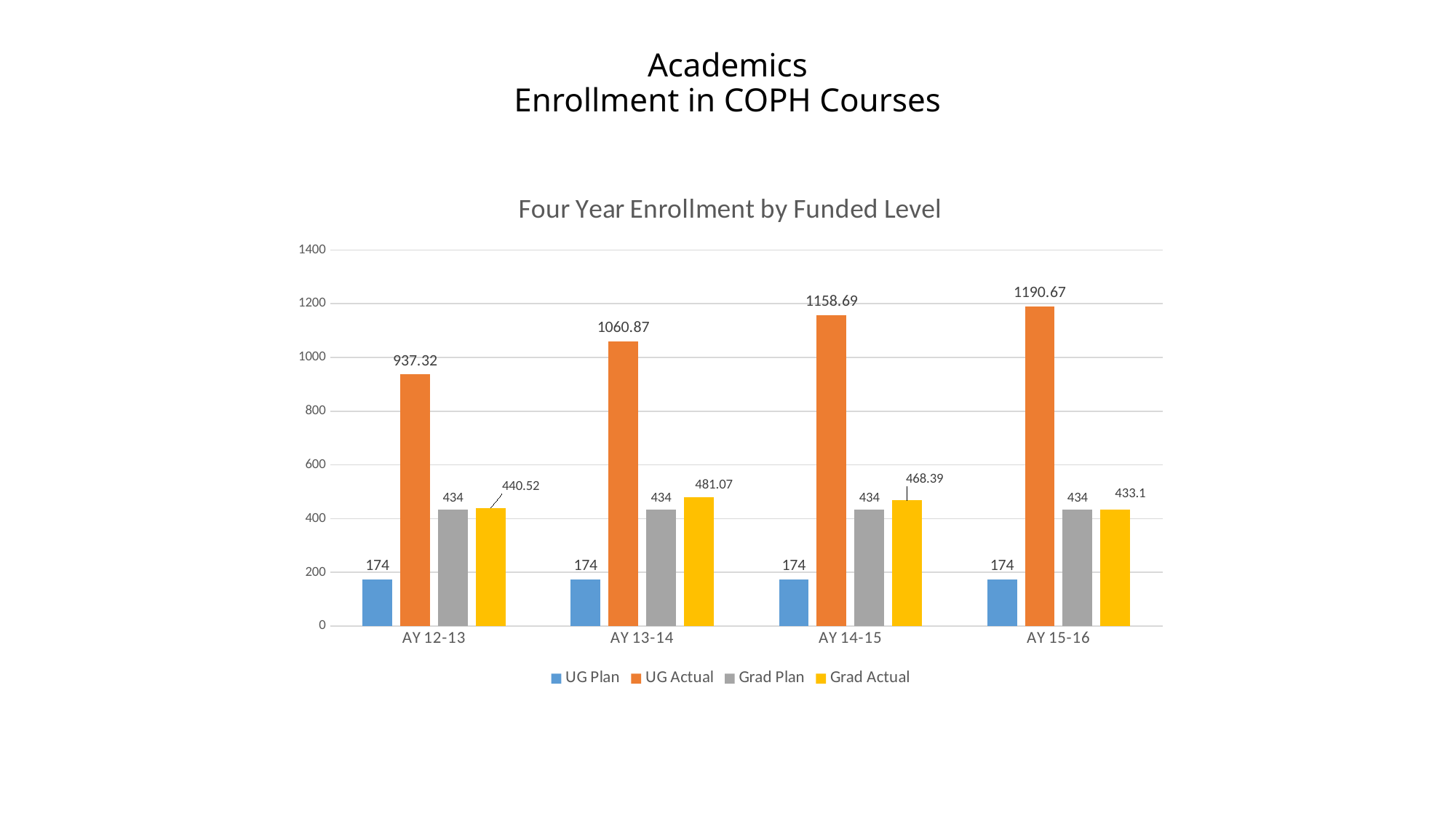
Which academic year has the lowest Grad Actual value? AY 15-16 How many series does the legend list? 4 What is the Grad Actual value for AY 14-15? 468.39 How many academic years are shown on the x axis? 4 Which academic year has the highest UG Actual value? AY 15-16 Is the UG Actual value for AY 14-15 greater or less than 1000? greater Does the UG Actual value rise or fall from AY 12-13 to AY 15-16? Rise Which is larger for AY 13-14: Grad Plan or Grad Actual? Grad Actual What is the difference between the UG Actual values for AY 15-16 and AY 12-13? 253.35 What kind of chart is shown on the slide? Bar chart What is the UG Actual value for AY 13-14? 1060.87 What is the UG Plan value for AY 15-16? 174